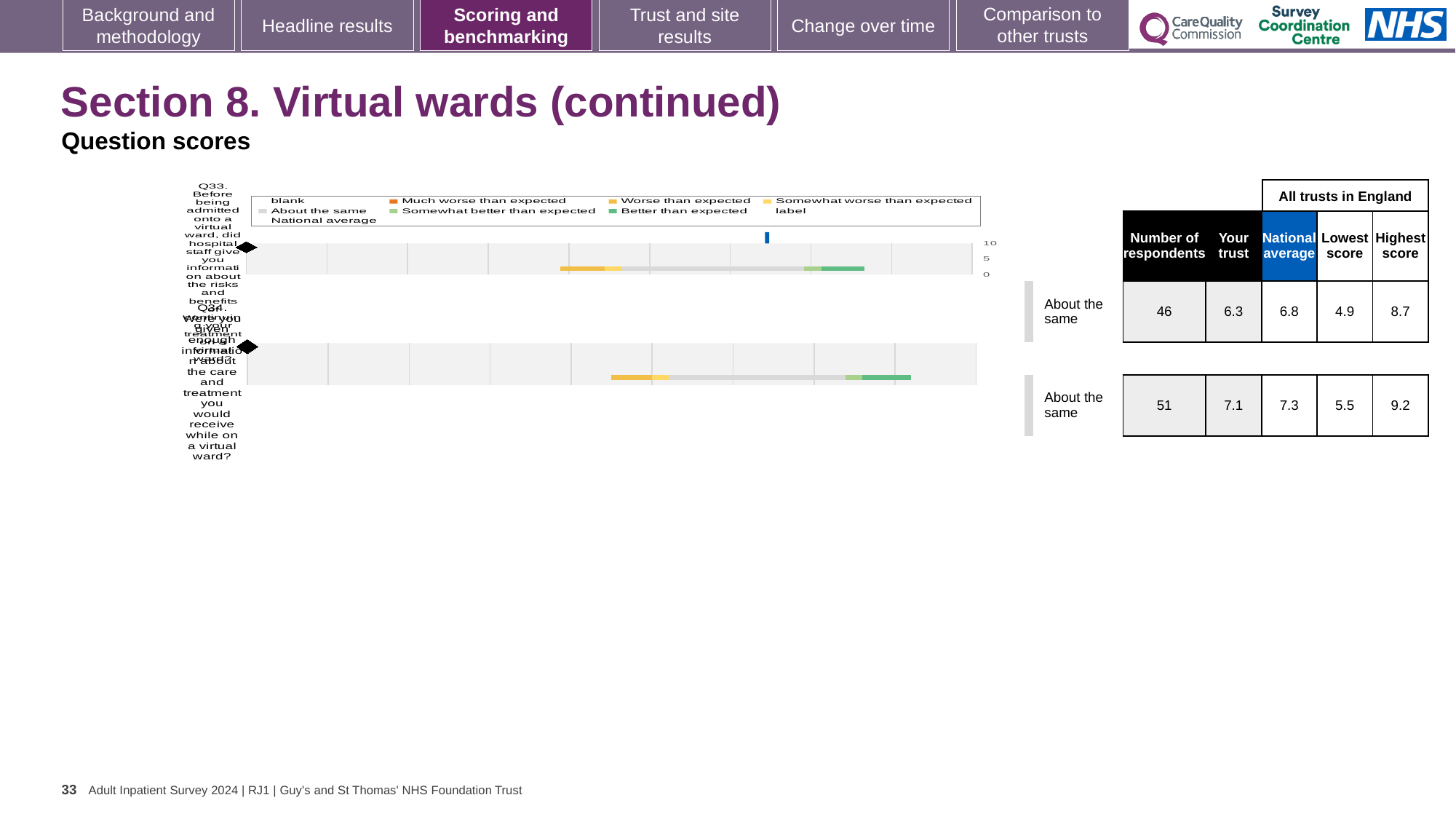
How many entries does the chart legend list? 9 What is the 'Your trust' score for Q34? 7.1 What kind of chart is used to show the question scores on this slide? Bar chart What is the national average score for Q33? 6.8 By how much does the national average exceed the 'Your trust' score for Q33? 0.5 Which question has the higher 'Your trust' score, Q33 or Q34? Q34 What is the 'Your trust' score for Q33? 6.3 What is the difference between the highest score and the lowest score for Q34? 3.7 Which benchmark category is shown for Q33? About the same How many questions (bars) are plotted in the chart? 2 Which question has the higher 'Highest score' across all trusts in England? Q34 How many respondents answered Q34? 51